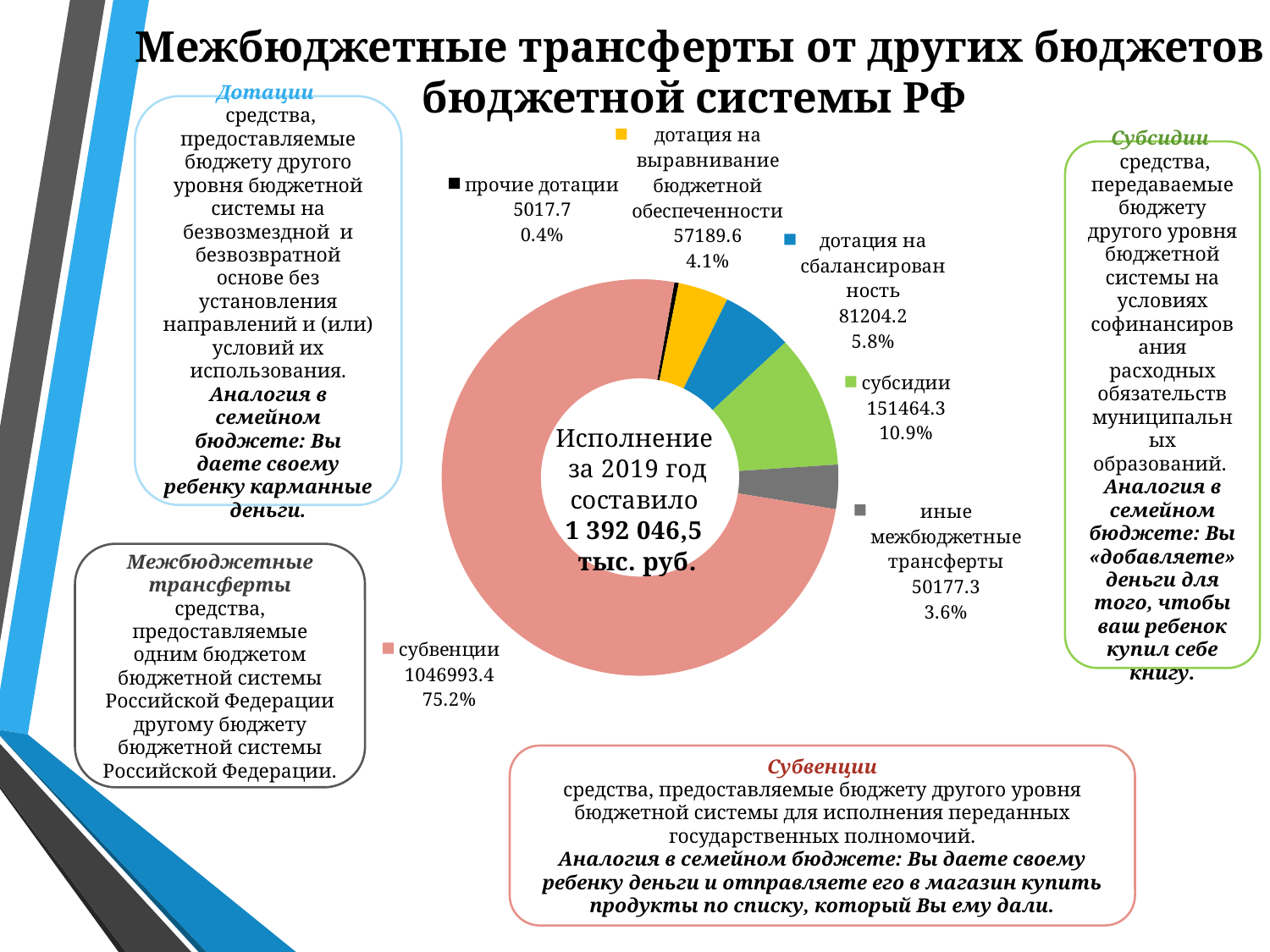
What colour is the субвенции slice? Pink (salmon) What share of the chart do субсидии make up? 10.9% What is the value shown for дотация на сбалансированность? 81204.2 How many slices does the chart have? 6 Which category has the smallest slice? прочие дотации What percentage is shown for иные межбюджетные трансферты? 3.6% What is the value shown for субвенции? 1046993.4 Which category has the largest slice? субвенции What kind of chart is shown on the slide? Doughnut (pie) chart What total amount is stated in the centre of the chart for 2019? 1 392 046,5 тыс. руб. What is the difference between the values for субсидии and дотация на сбалансированность? 70260.1 Which is larger: субсидии or дотация на выравнивание бюджетной обеспеченности? субсидии